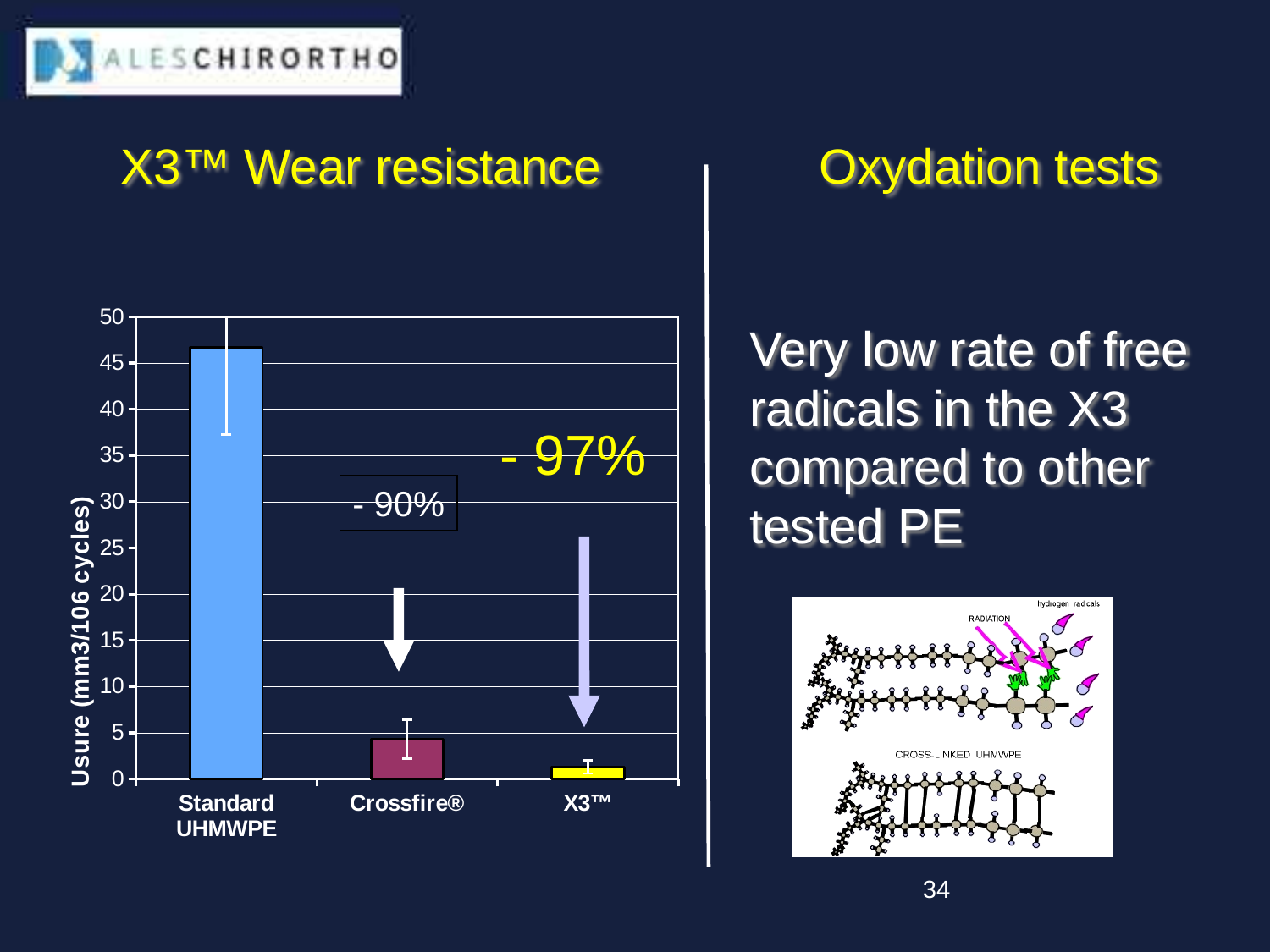
Is the value for Standard UHMWPE greater or less than 50? less Which category has the highest wear value in the chart? Standard UHMWPE What is the label of the y axis of the wear resistance chart? Usure (mm3/106 cycles) Which has a larger wear value, Standard UHMWPE or Crossfire®? Standard UHMWPE Which has a larger wear value, Crossfire® or X3™? Crossfire® Is the value for X3™ greater or less than 5? less How many categories are plotted on the x axis of the wear resistance chart? 3 Is the value for Standard UHMWPE greater or less than 40? greater What percentage reduction is annotated next to the X3™ bar? - 97% Which category has the lowest wear value in the chart? X3™ What kind of chart is shown under the title "X3™ Wear resistance"? bar chart